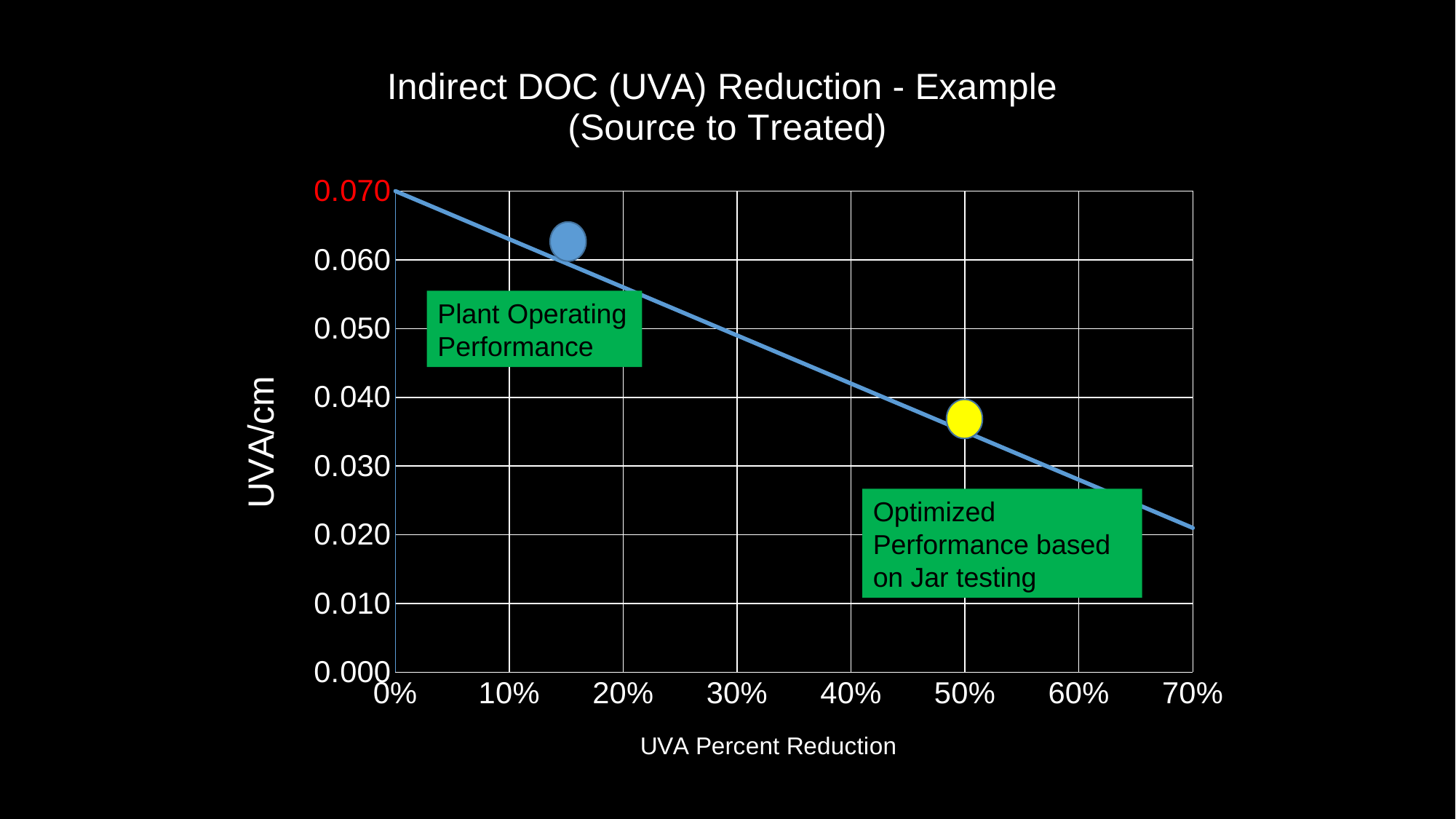
Is the UVA Percent Reduction of the Plant Operating Performance marker greater or less than 20%? less What is the UVA/cm value of the line at 0% UVA Percent Reduction? 0.070 What is the label of the x axis? UVA Percent Reduction Is the UVA/cm value of the Optimized Performance based on Jar testing marker greater or less than 0.040? less Is the UVA/cm value of the Plant Operating Performance marker greater or less than 0.050? greater Which marker has the higher UVA/cm value, Plant Operating Performance or Optimized Performance based on Jar testing? Plant Operating Performance What is the title of the chart? Indirect DOC (UVA) Reduction - Example (Source to Treated) At what UVA Percent Reduction is the Optimized Performance based on Jar testing marker plotted? 50% Does the UVA/cm value rise or fall as UVA Percent Reduction increases along the x axis? fall What kind of chart is shown on the slide? line chart How many highlighted marker points are plotted on the line? 2